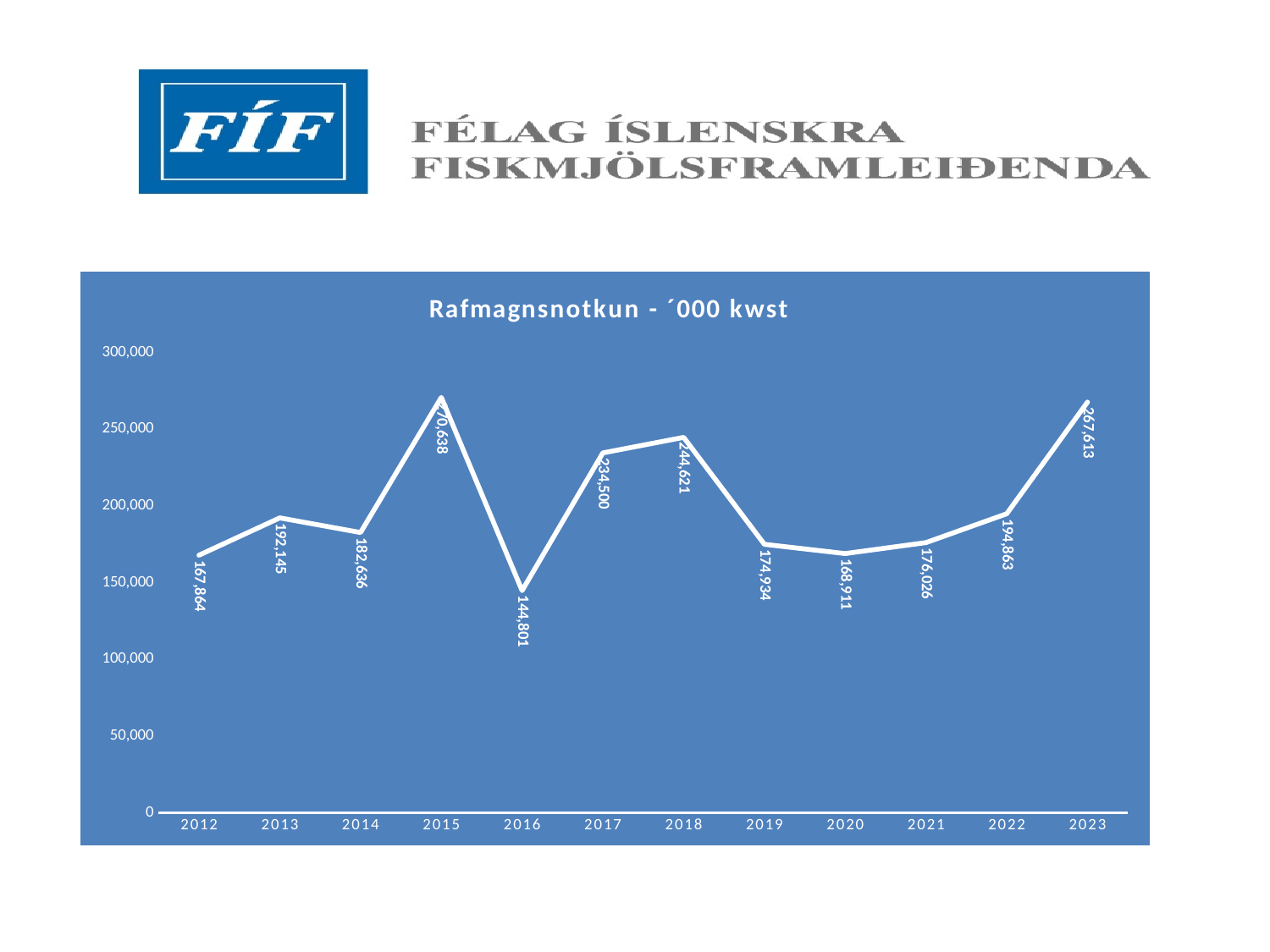
What is the value for 2016? 144,801 What is the value for 2012? 167,864 Is the value for 2015 greater or less than 250,000? greater What is the difference between the values for 2023 and 2022? 72,750 Which is larger, the value for 2013 or the value for 2014? 2013 What kind of chart is shown? line chart What is the title of the chart? Rafmagnsnotkun - ´000 kwst What is the value for 2018? 244,621 What is the value for 2023? 267,613 Which year has the lowest value? 2016 What is the difference between the values for 2018 and 2017? 10,121 How many years are plotted on the chart? 12